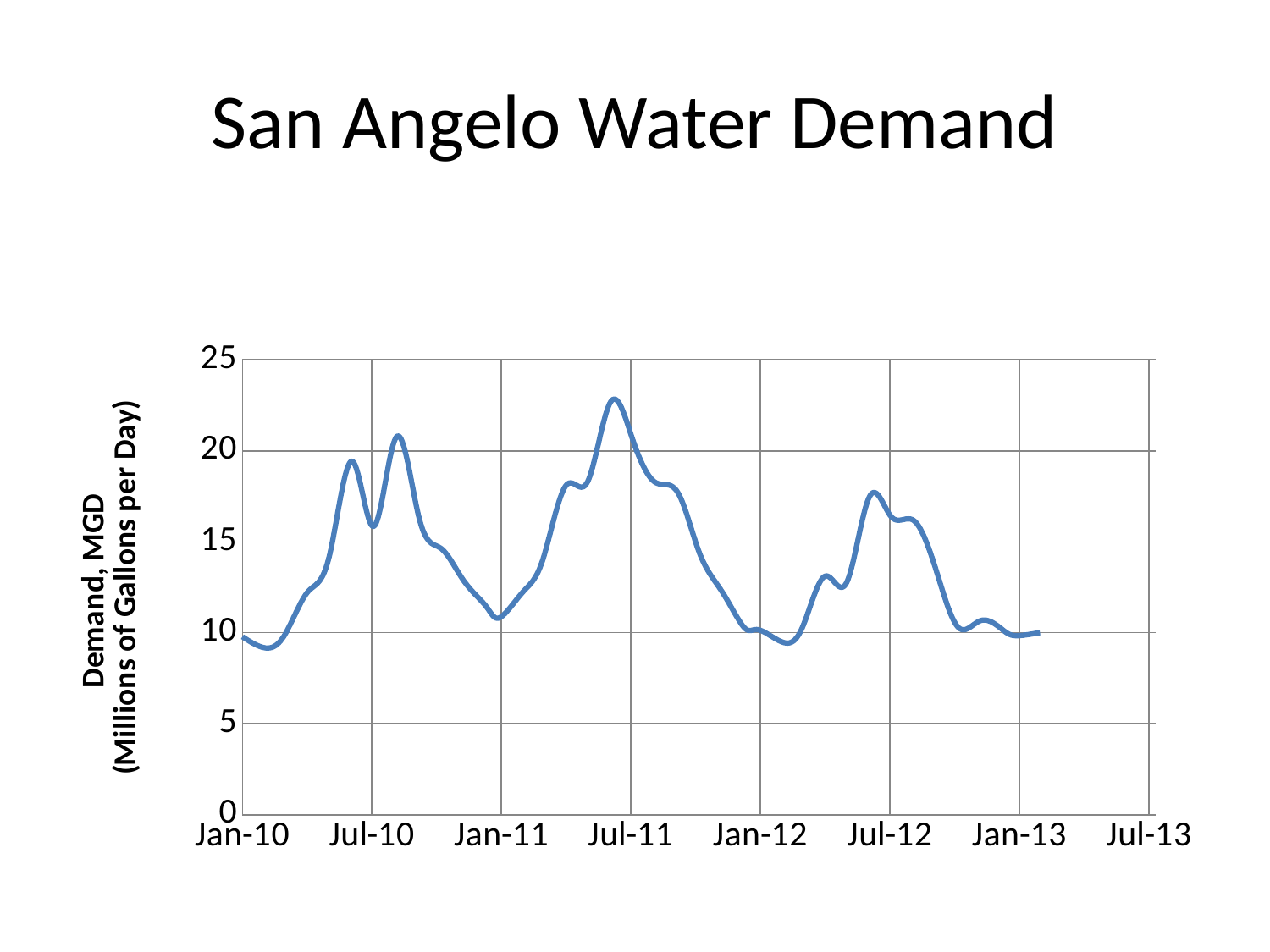
In which summer does the line reach its highest peak: 2010, 2011 or 2012? 2011 Is the value at Jul-10 greater or less than 15? greater What kind of chart is shown on the slide? line chart Which is larger, the value at Jul-10 or the value at Jan-11? Jul-10 Is the value at Jul-11 greater or less than 20? greater Is the value at Jan-13 greater or less than 15? less Do the values rise or fall between Jul-11 and Jan-12? fall What is the title of the chart? San Angelo Water Demand What is the label of the vertical axis? Demand, MGD (Millions of Gallons per Day) How many tick labels are shown on the horizontal axis? 8